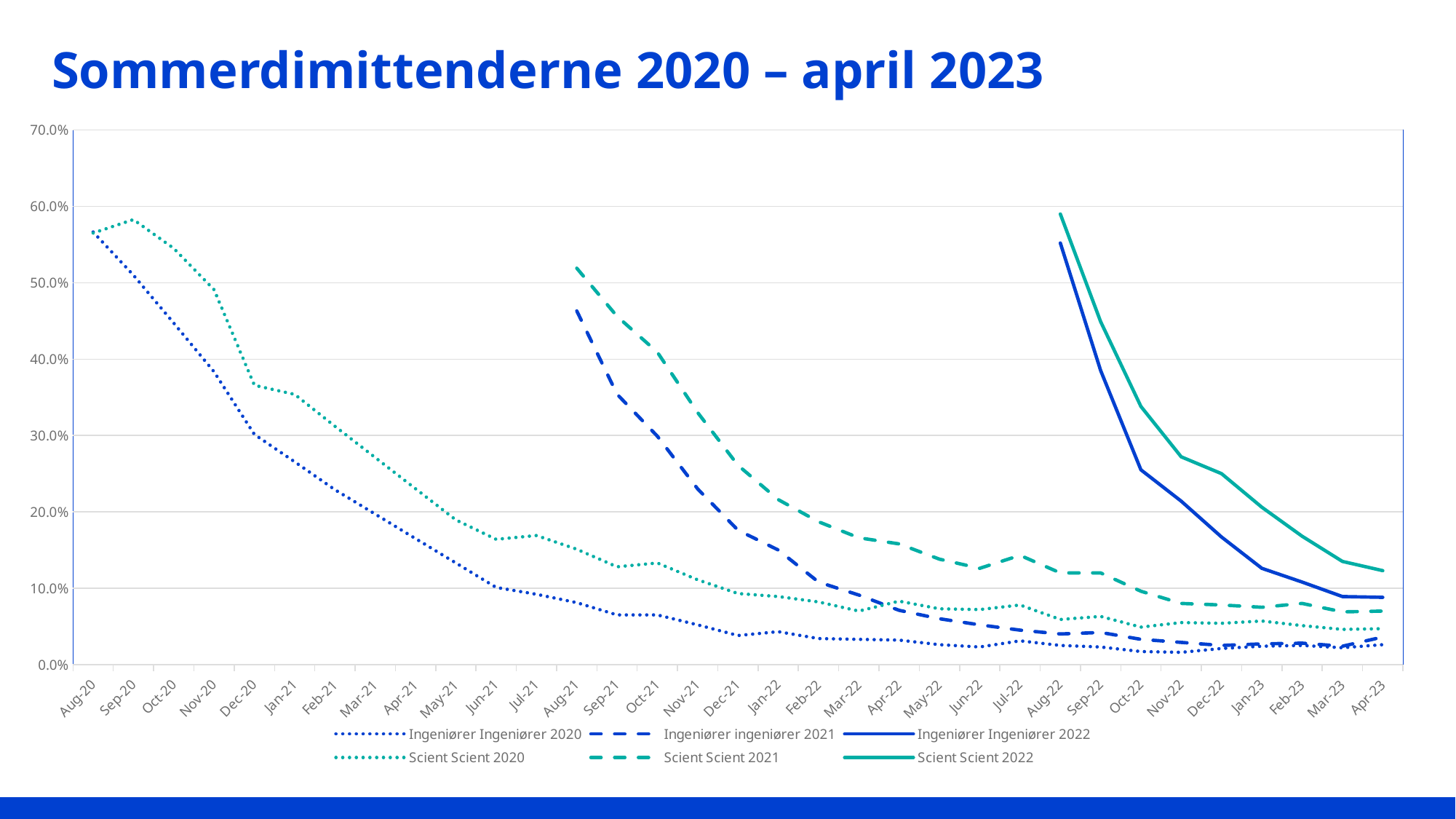
In Aug-22, which is higher: Scient Scient 2022 or Ingeniører Ingeniører 2022? Scient Scient 2022 What kind of chart is shown on the slide? Line chart What is the title of the slide? Sommerdimittenderne 2020 – april 2023 Is the value for Scient Scient 2022 in Aug-22 greater or less than 50.0%? greater How many months are shown along the x axis? 33 Is the value for Ingeniører Ingeniører 2020 in Apr-23 greater or less than 10.0%? less In Apr-23, which is higher: Scient Scient 2022 or Ingeniører Ingeniører 2022? Scient Scient 2022 Does the Ingeniører Ingeniører 2022 series rise or fall from Aug-22 to Apr-23? Fall Is the value for Ingeniører ingeniører 2021 in Aug-21 greater or less than 50.0%? less How many series does the legend list? 6 Which line style is used for the 2022 series in the legend? Solid